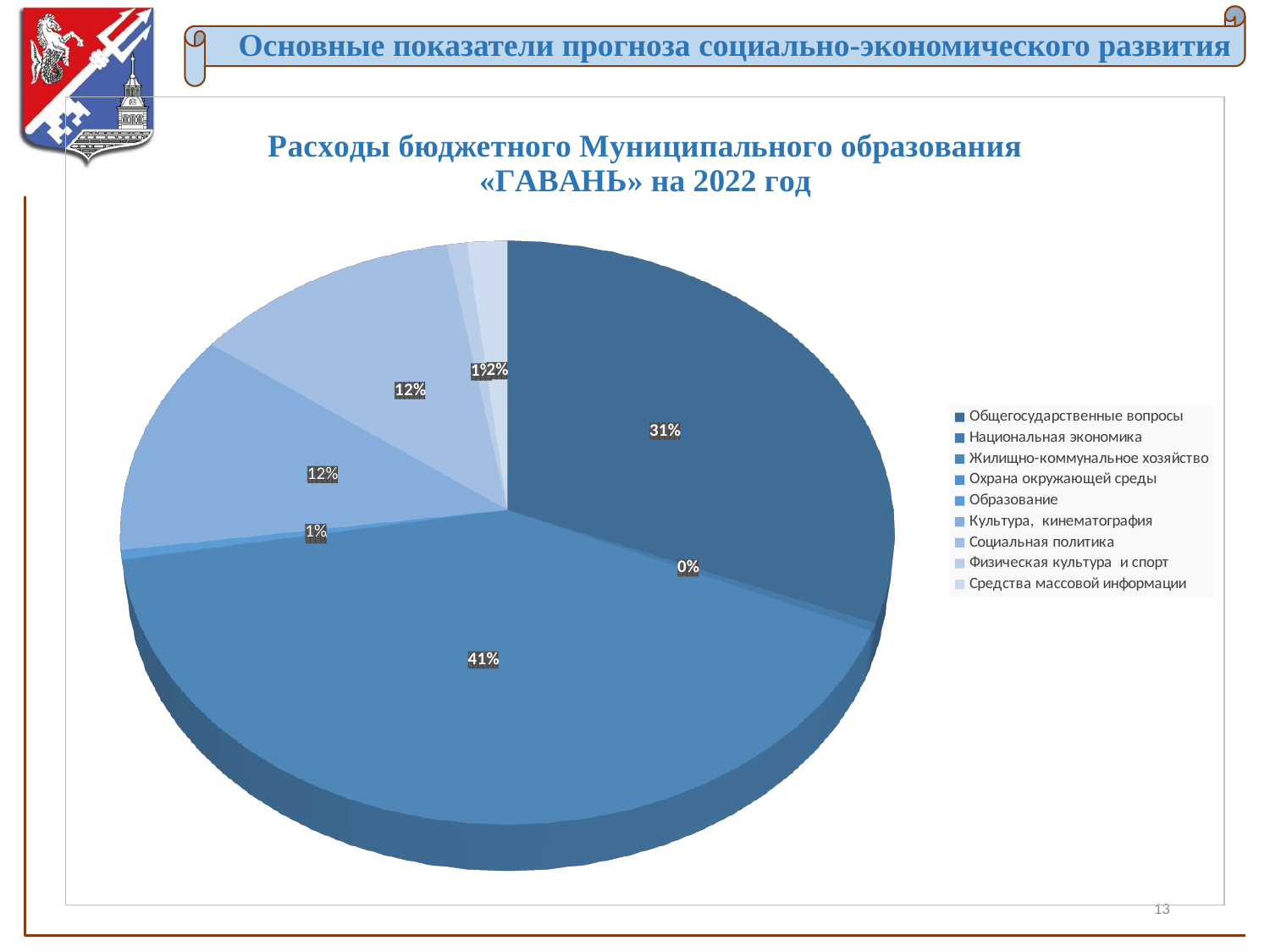
What is the difference in percentage points between the shares of Жилищно-коммунальное хозяйство and Общегосударственные вопросы? 10 Which category has the largest share of the pie? Жилищно-коммунальное хозяйство Which has a larger share: Общегосударственные вопросы or Образование? Общегосударственные вопросы What share of the pie does Общегосударственные вопросы have? 31% What share of the pie does Национальная экономика have? 0% What share of the pie does Культура, кинематография have? 12% What is the title of the chart? Расходы бюджетного Муниципального образования «ГАВАНЬ» на 2022 год How many categories does the legend list? 9 What kind of chart is shown on the slide? Pie chart